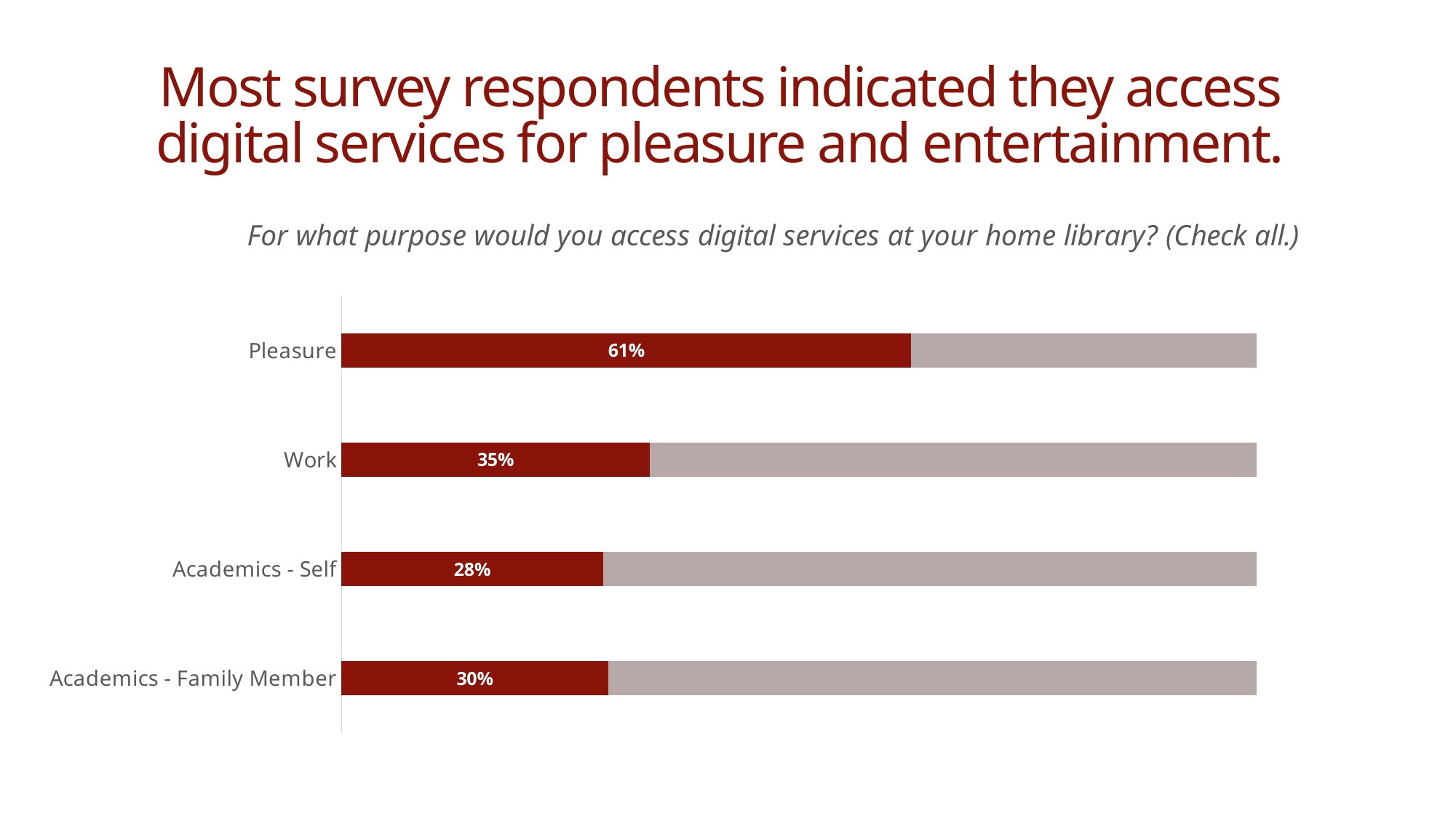
Which purpose has the highest percentage of respondents? Pleasure What is the difference in percentage points between Academics - Family Member and Academics - Self? 2 Which is larger, the value for Work or the value for Academics - Family Member? Work What percentage of respondents indicated they access digital services for Academics - Family Member? 30% What survey question is shown as the chart's subtitle? For what purpose would you access digital services at your home library? (Check all.) What kind of chart is shown on the slide? Bar chart What percentage of respondents indicated they access digital services for Work? 35% What is the difference in percentage points between Pleasure and Work? 26 What percentage of respondents indicated they access digital services for Pleasure? 61% What percentage of respondents indicated they access digital services for Academics - Self? 28% Which purpose has the lowest percentage of respondents? Academics - Self How many purpose categories are shown in the chart? 4